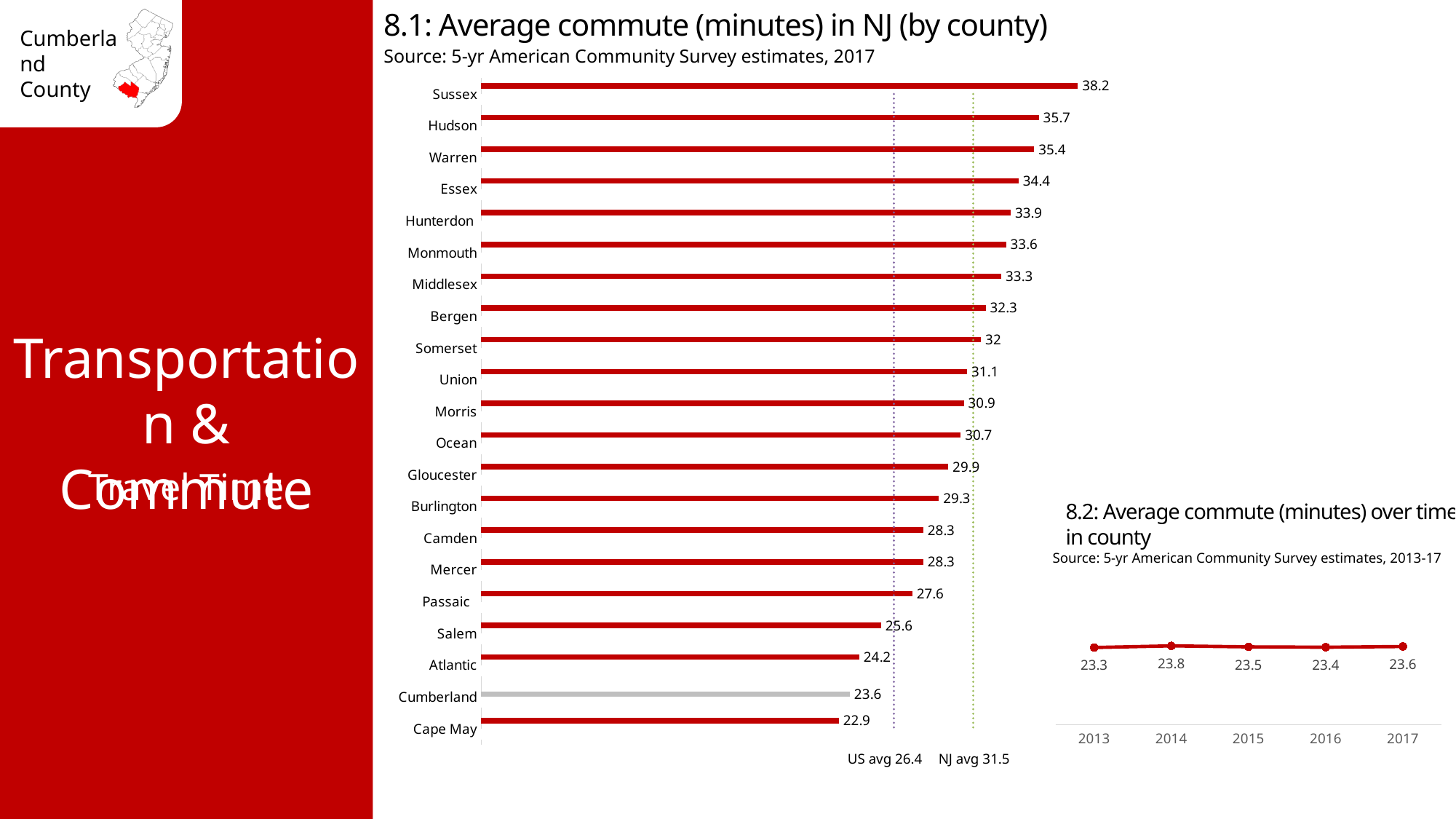
In chart 8.1 (Average commute in NJ by county), what is the average commute for Cumberland? 23.6 In chart 8.1 (Average commute in NJ by county), what is the NJ average commute shown? 31.5 In chart 8.2 (Average commute over time in county), which year has the lowest value? 2013 What kind of chart is chart 8.1 (Average commute in NJ by county)? Bar chart In chart 8.1 (Average commute in NJ by county), how many counties are shown? 21 In chart 8.1 (Average commute in NJ by county), what is the difference between Sussex and Cape May? 15.3 In chart 8.1 (Average commute in NJ by county), which county has the lowest average commute? Cape May In chart 8.1 (Average commute in NJ by county), what is the average commute for Sussex? 38.2 In chart 8.1 (Average commute in NJ by county), which has a longer average commute, Hudson or Bergen? Hudson In chart 8.2 (Average commute over time in county), how many years are plotted? 5 In chart 8.2 (Average commute over time in county), what is the value for 2014? 23.8 In chart 8.1 (Average commute in NJ by county), which county has the highest average commute? Sussex